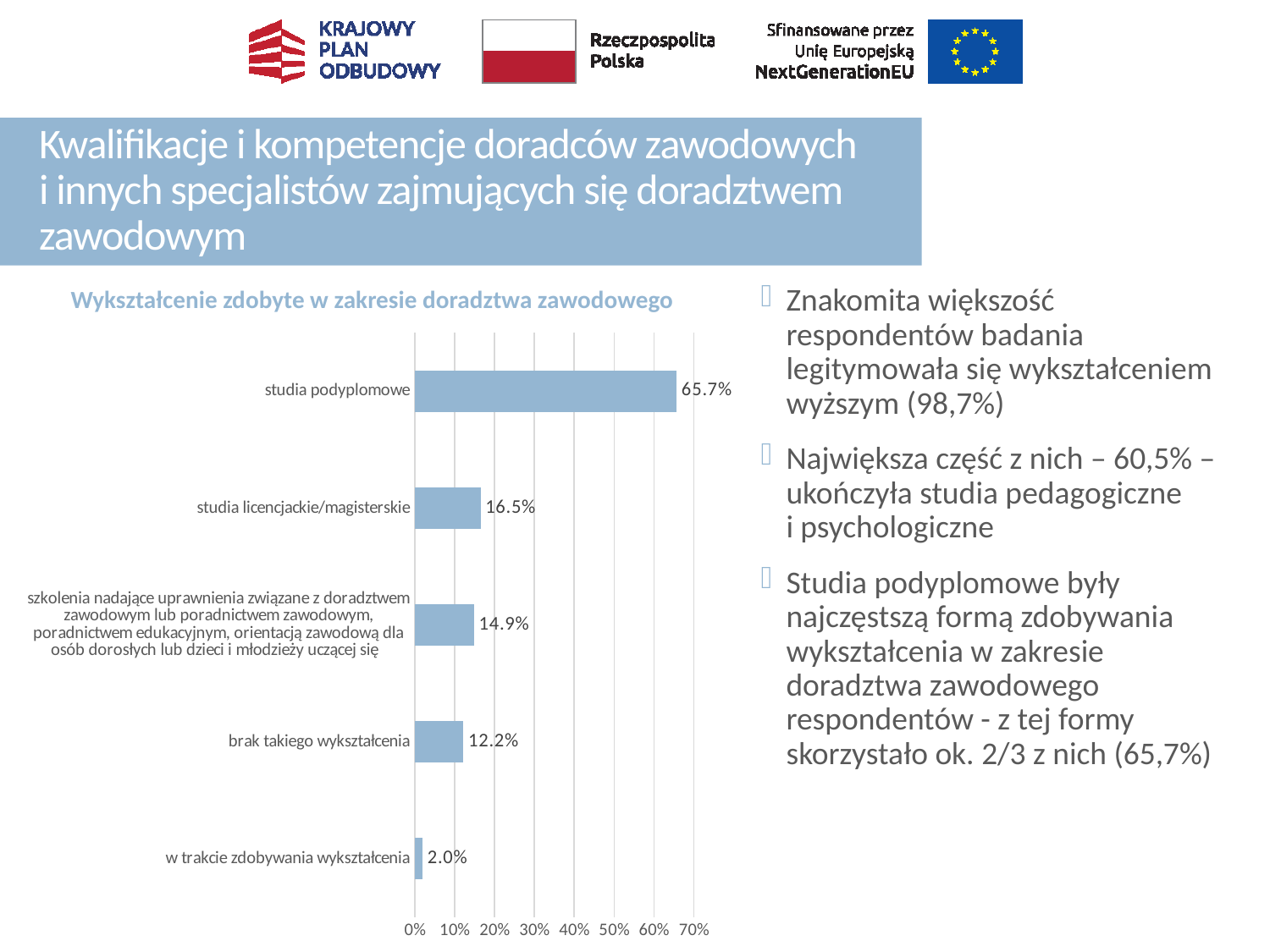
What is the value for 'brak takiego wykształcenia'? 12.2% What is the value for 'studia podyplomowe'? 65.7% Which category has the highest value? studia podyplomowe What is the value for 'w trakcie zdobywania wykształcenia'? 2.0% Which is larger: the value for 'brak takiego wykształcenia' or the value for 'w trakcie zdobywania wykształcenia'? brak takiego wykształcenia Is the value for 'studia podyplomowe' greater or less than 60%? greater What is the value for 'studia licencjackie/magisterskie'? 16.5% What is the difference between the values for 'studia podyplomowe' and 'studia licencjackie/magisterskie'? 49.2% What is the title of the chart? Wykształcenie zdobyte w zakresie doradztwa zawodowego What kind of chart is shown on the slide? bar chart Which category has the lowest value? w trakcie zdobywania wykształcenia How many categories are shown in the chart? 5